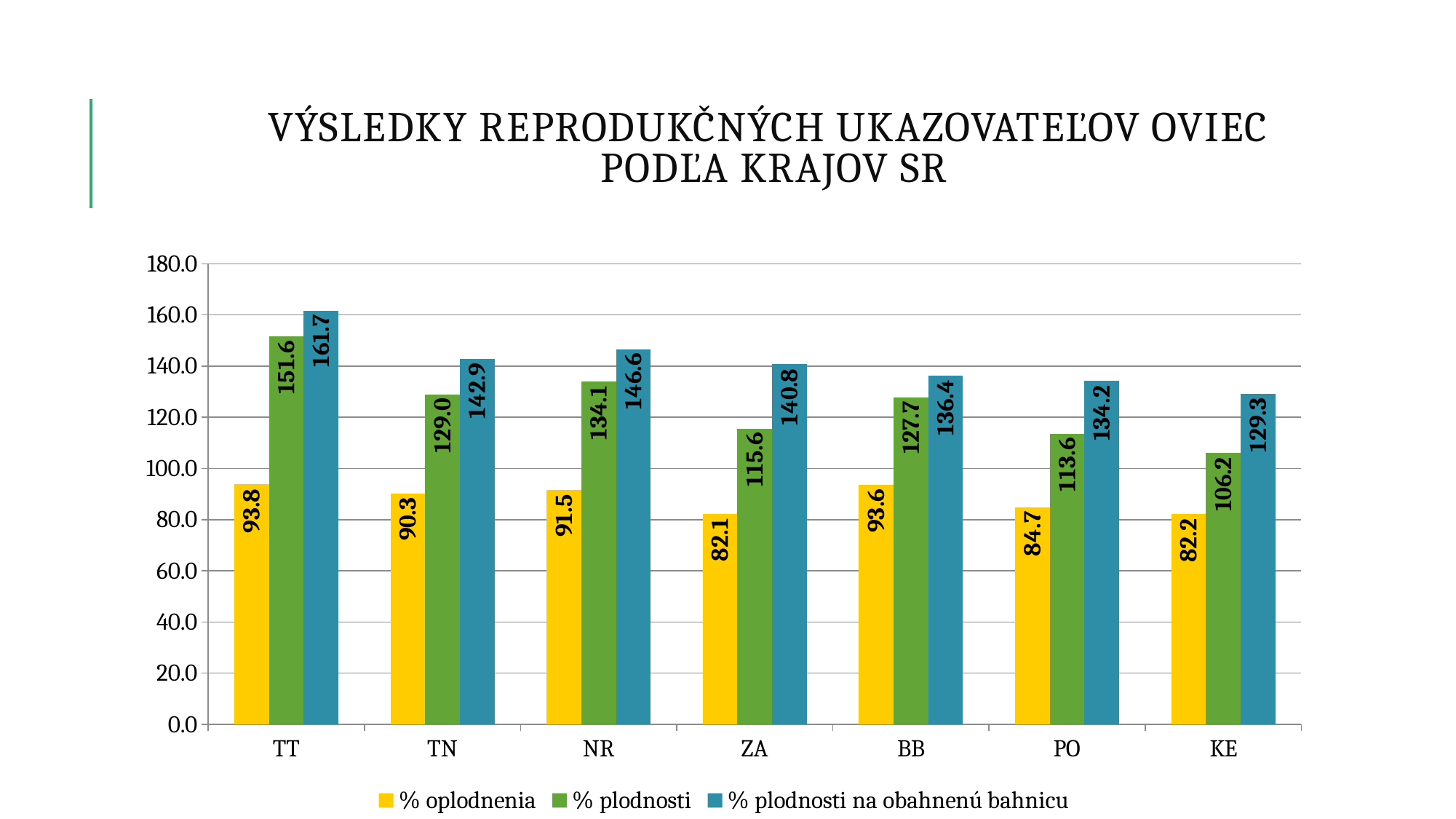
Which region has the lowest % plodnosti? KE What is the difference between % plodnosti and % oplodnenia for NR? 42.6 How many regions are shown on the x axis? 7 How many series does the legend list? 3 What is the % oplodnenia value for ZA? 82.1 What is the % plodnosti na obahnenú bahnicu value for PO? 134.2 What kind of chart is shown on the slide? bar chart Which region has the highest % plodnosti na obahnenú bahnicu? TT What is the difference between % plodnosti na obahnenú bahnicu and % plodnosti for TT? 10.1 Which is larger, the % plodnosti for NR or for ZA? NR What is the % plodnosti value for TT? 151.6 Is the % plodnosti na obahnenú bahnicu value for KE greater or less than 140? less